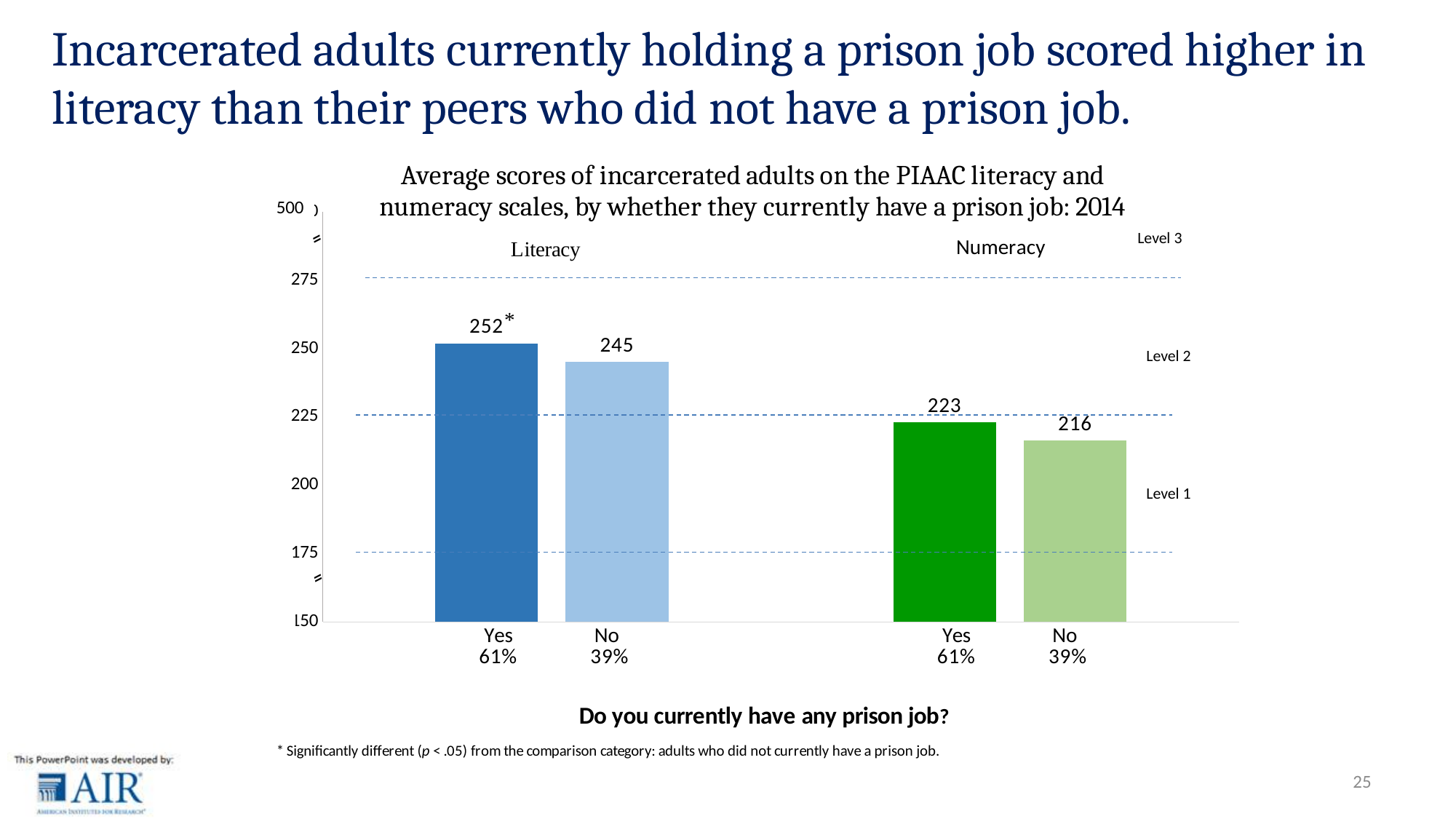
Which is larger: the literacy score for No or the numeracy score for Yes? Literacy score for No Which bar shows the lowest average score? Numeracy, No Is the numeracy score for adults without a prison job greater or less than 225? less What is the average numeracy score for incarcerated adults who do not currently have a prison job (No)? 216 What is the average literacy score for incarcerated adults who do not currently have a prison job (No)? 245 How many bars are plotted in the chart? 4 What is the average literacy score for incarcerated adults who currently have a prison job (Yes)? 252 What is the average numeracy score for incarcerated adults who currently have a prison job (Yes)? 223 Which bar shows the highest average score? Literacy, Yes What is the difference between the literacy scores of adults with a prison job and those without? 7 What is the difference between the numeracy scores of adults with a prison job and those without? 7 What type of chart is shown on the slide? Bar chart